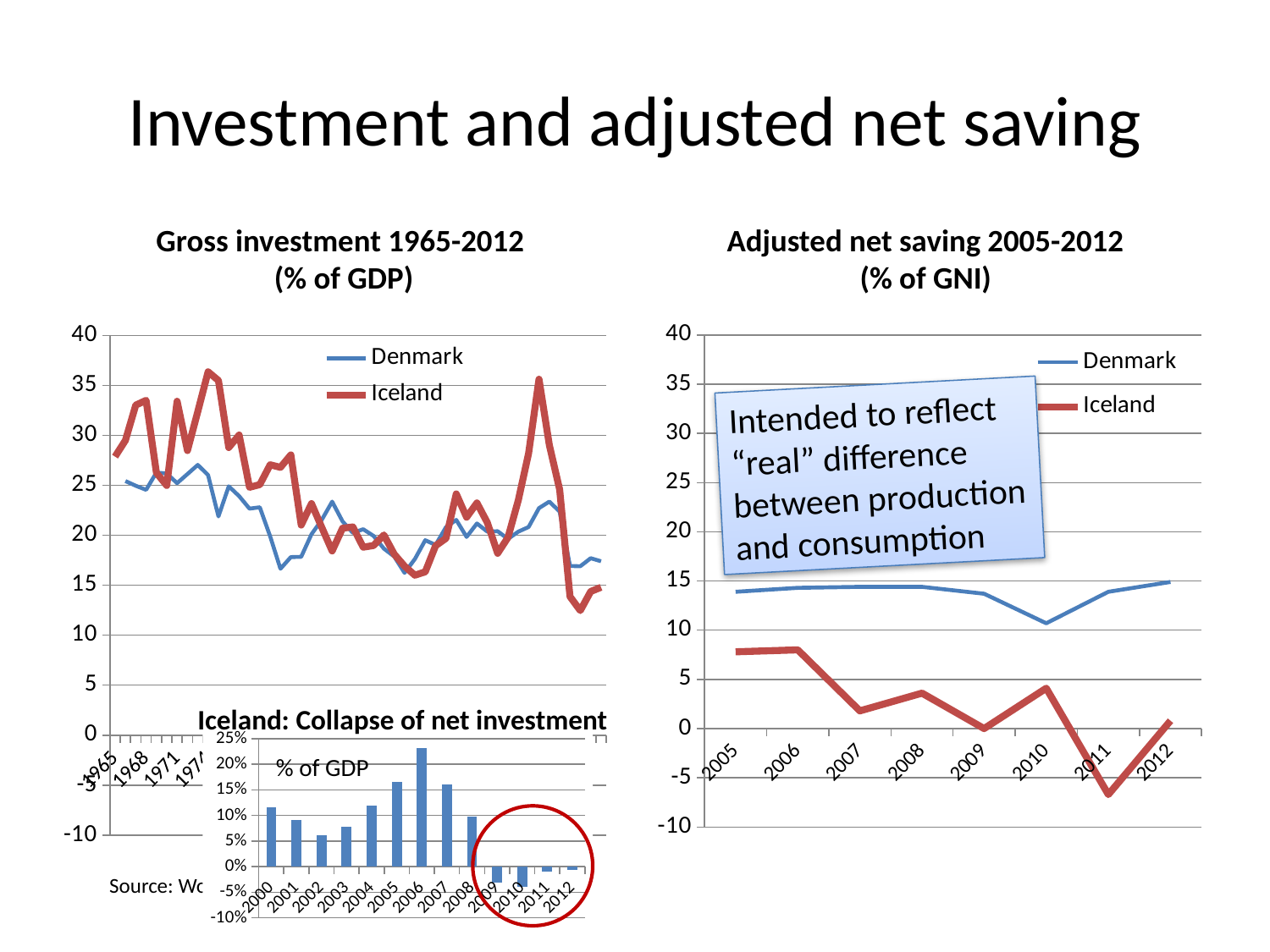
In the "Iceland: Collapse of net investment" chart, is the value for 2006 greater or less than 20%? greater In the "Iceland: Collapse of net investment" chart, which year has the highest bar? 2006 In the "Adjusted net saving 2005-2012 (% of GNI)" chart, is the value for Denmark in 2010 greater or less than 15? less What kind of chart is the "Iceland: Collapse of net investment" chart? bar chart In the "Adjusted net saving 2005-2012 (% of GNI)" chart, in which year is Iceland's value lowest? 2011 In the "Adjusted net saving 2005-2012 (% of GNI)" chart, does Denmark's value rise or fall from 2009 to 2010? fall In the "Adjusted net saving 2005-2012 (% of GNI)" chart, is the value for Iceland in 2011 greater or less than 0? less In the "Adjusted net saving 2005-2012 (% of GNI)" chart, which series has the higher value in 2012? Denmark How many series does the legend of the "Gross investment 1965-2012 (% of GDP)" chart list? 2 How many years are shown on the x axis of the "Iceland: Collapse of net investment" chart? 13 In the "Gross investment 1965-2012 (% of GDP)" chart, which series reaches the highest value? Iceland What kind of chart is the "Gross investment 1965-2012 (% of GDP)" chart? line chart